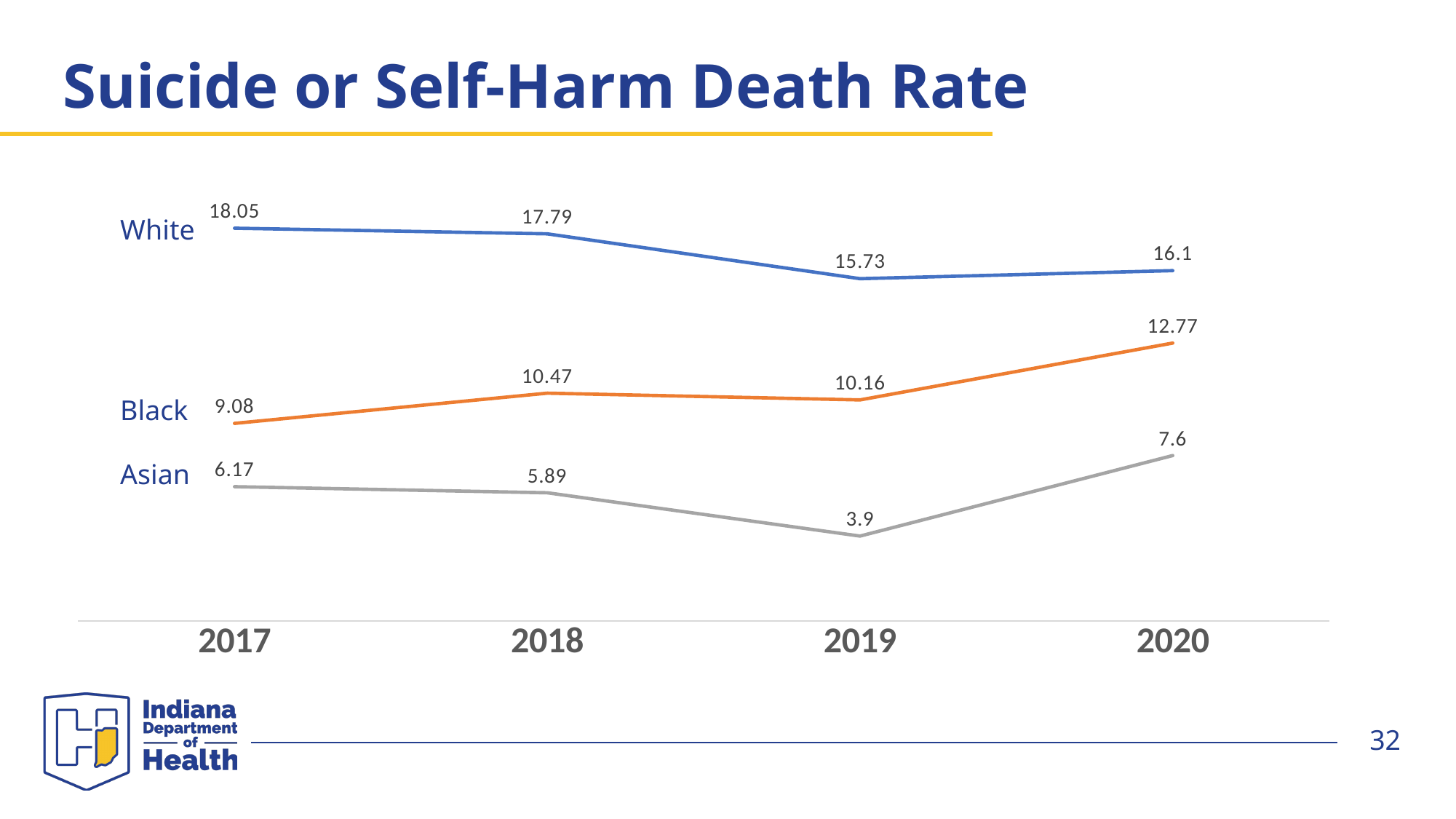
How many years are shown on the x axis? 4 In which year is the Asian death rate lowest? 2019 How many series (groups) are plotted on the chart? 3 What is the difference between the White and Black death rates in 2020? 3.33 What is the suicide or self-harm death rate for Asian in 2019? 3.9 What is the suicide or self-harm death rate for Black in 2020? 12.77 Does the White death rate rise or fall from 2017 to 2019? Fall Which group has a higher death rate in 2018, Black or Asian? Black What is the suicide or self-harm death rate for White in 2017? 18.05 In which year is the Black death rate highest? 2020 What kind of chart is shown on the slide? Line chart What is the title of the slide? Suicide or Self-Harm Death Rate